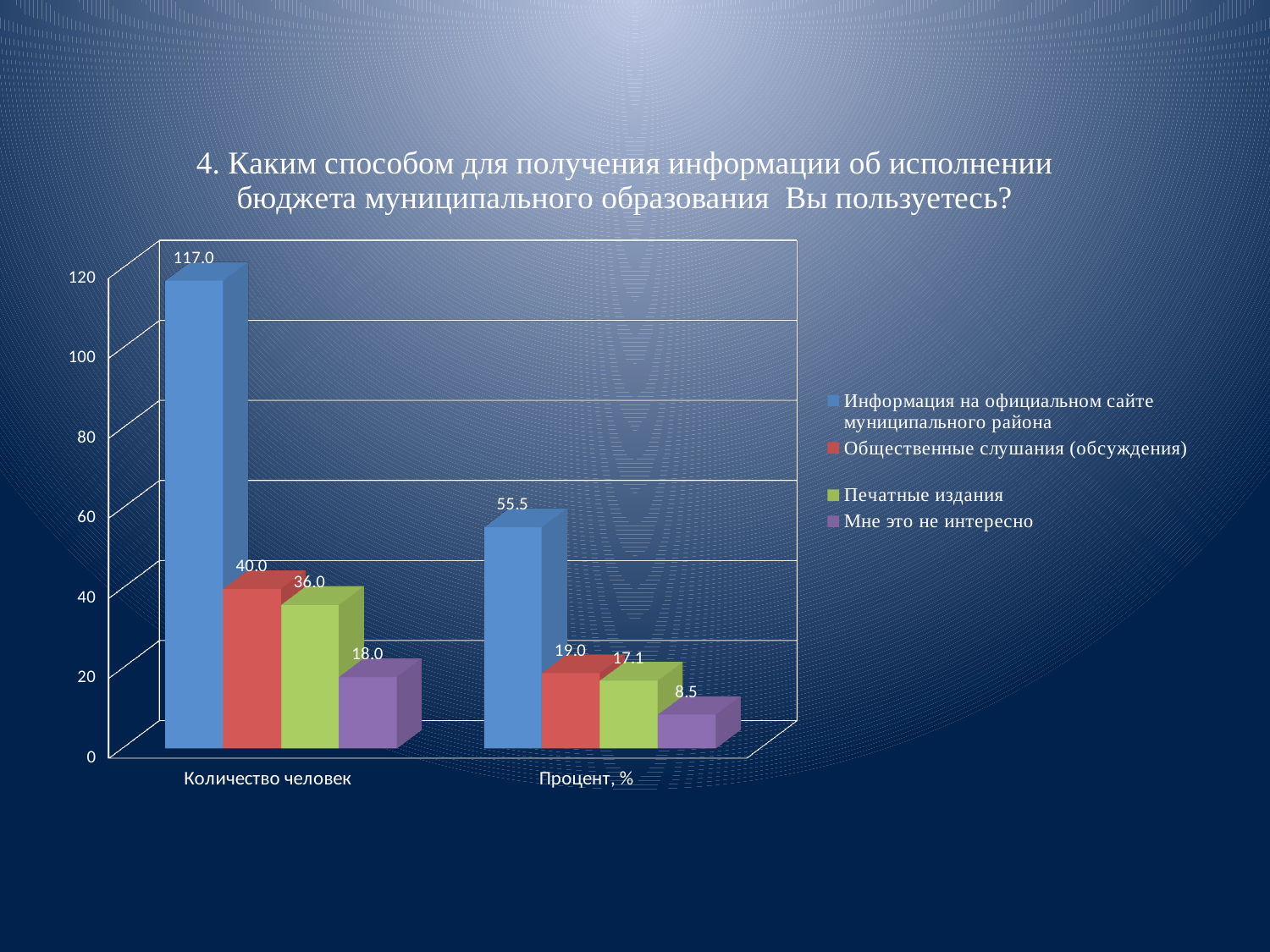
What is the value for "Печатные издания" in the "Количество человек" category? 36.0 Which is larger in the "Процент, %" category: "Печатные издания" or "Мне это не интересно"? Печатные издания Which series has the highest value in the "Количество человек" category? Информация на официальном сайте муниципального района How many series does the legend list? 4 What is the value for "Информация на официальном сайте муниципального района" in the "Количество человек" category? 117.0 What is the value for "Мне это не интересно" in the "Процент, %" category? 8.5 Is the value for "Информация на официальном сайте муниципального района" in the "Процент, %" category greater or less than 60? less What is the value for "Общественные слушания (обсуждения)" in the "Процент, %" category? 19.0 Which series has the lowest value in the "Процент, %" category? Мне это не интересно What kind of chart is shown on the slide? bar chart How many categories are shown on the x axis? 2 What is the difference between the "Общественные слушания (обсуждения)" and "Печатные издания" values in the "Количество человек" category? 4.0